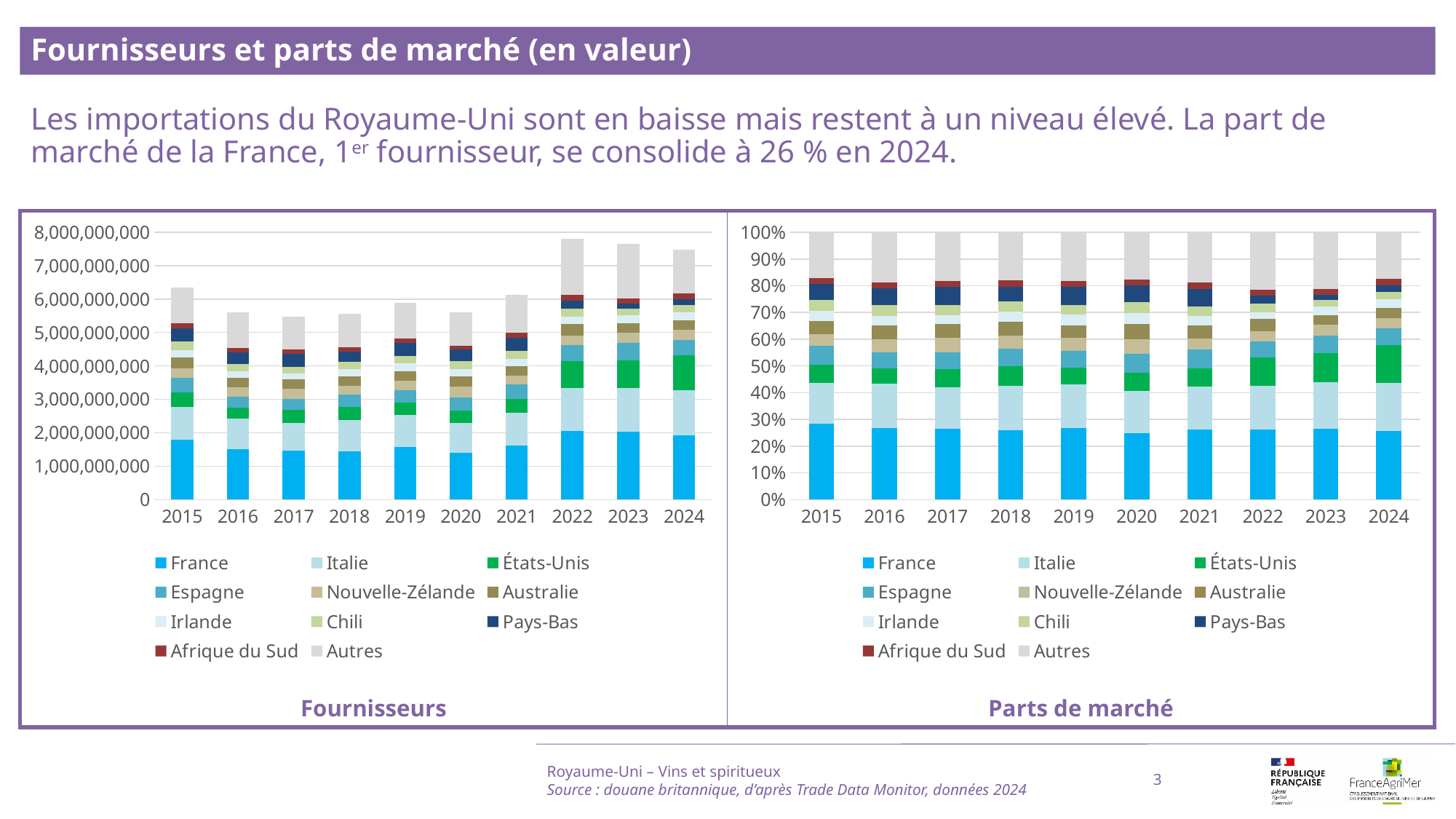
What kind of chart is the 'Fournisseurs' chart on the left? stacked bar chart What is the title shown below the right-hand chart? Parts de marché How many series does the legend of the 'Fournisseurs' chart list? 11 In the 'Parts de marché' chart, is the France share for 2024 greater or less than 30%? less In the 'Fournisseurs' chart, is the total stacked value for 2022 greater or less than 7,000,000,000? greater In the 'Fournisseurs' chart, is the France value for 2015 greater or less than 1,000,000,000? greater In the 'Fournisseurs' chart, which is larger: the total stacked value for 2021 or for 2022? 2022 In the 'Fournisseurs' chart, did the total stacked value rise or fall from 2021 to 2022? rise Which series is listed first in the legend of the 'Parts de marché' chart? France In the 'Fournisseurs' chart, which is larger: the France value for 2015 or for 2020? 2015 How many years are shown on the x axis of the 'Parts de marché' chart? 10